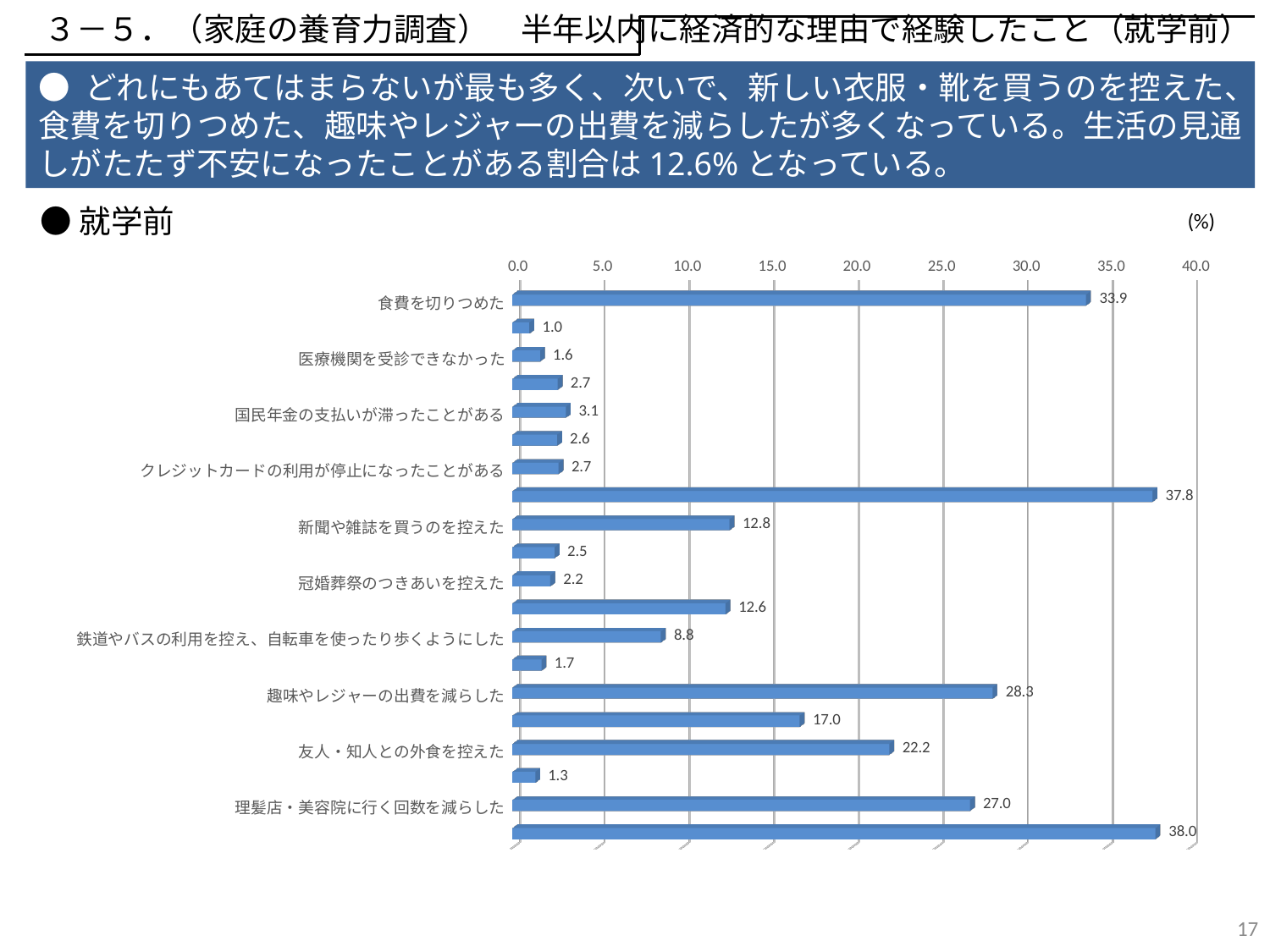
What is the value for 友人・知人との外食を控えた? 22.2 What is the difference between the values for 食費を切りつめた and 趣味やレジャーの出費を減らした? 5.6 What is the value for 趣味やレジャーの出費を減らした? 28.3 What is the smallest value shown on the chart? 1.0 What kind of chart is shown on the slide? bar chart What is the value for 食費を切りつめた? 33.9 What unit is indicated at the top right of the chart? (%) What is the value for 医療機関を受診できなかった? 1.6 What is the value for 鉄道やバスの利用を控え、自転車を使ったり歩くようにした? 8.8 What is the value for 理髪店・美容院に行く回数を減らした? 27.0 Which is larger, the value for 友人・知人との外食を控えた or 理髪店・美容院に行く回数を減らした? 理髪店・美容院に行く回数を減らした What is the largest value shown on the chart? 38.0